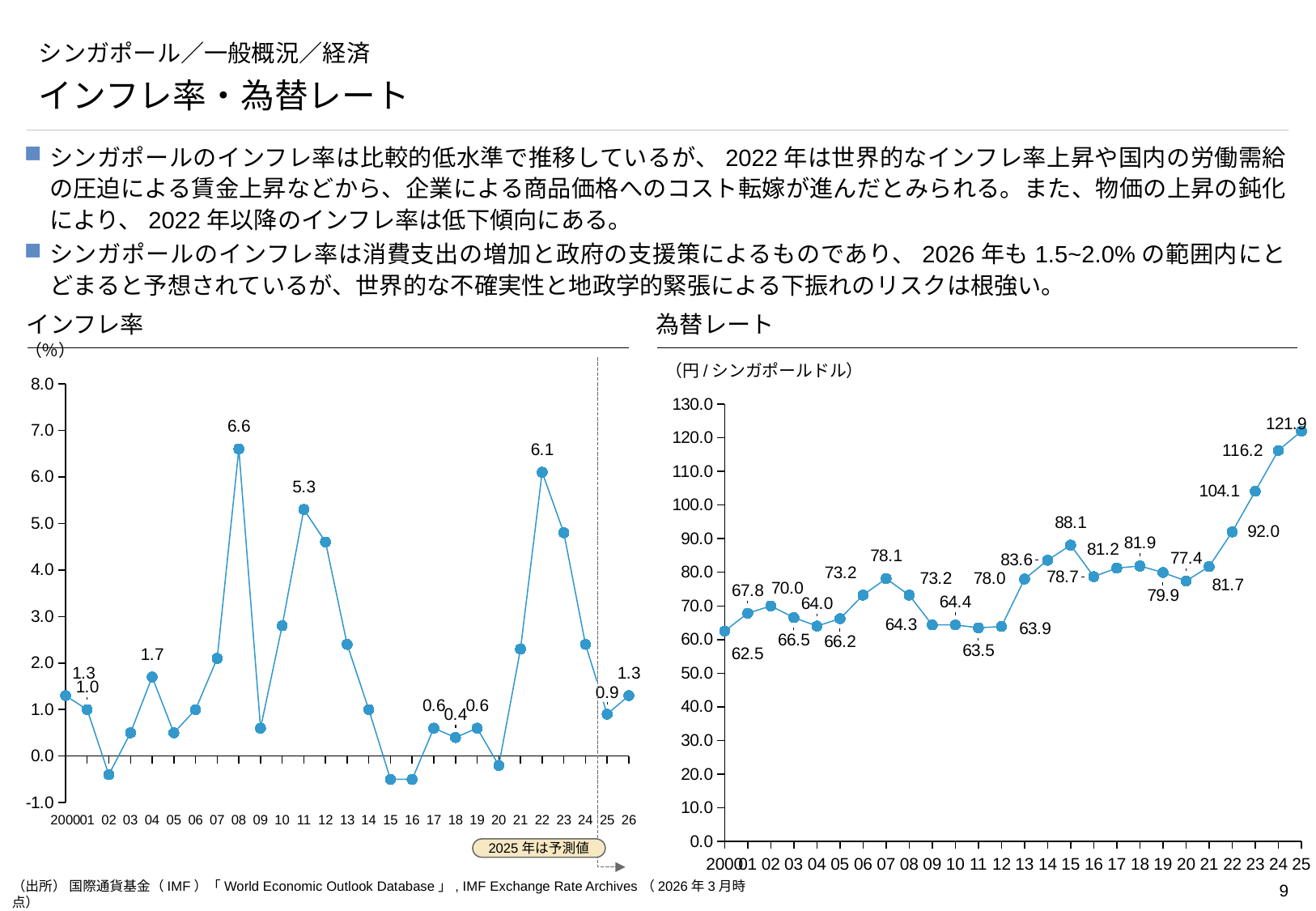
In the 為替レート chart, which year has the lowest value? 2000 In the インフレ率 chart, is the value for 2023 greater or less than 4.0? greater In the 為替レート chart, what is the difference between the 2025 value and the 2024 value? 5.7 What kind of chart is the インフレ率 chart? line chart In the インフレ率 chart, what is the difference between the 2008 value and the 2022 value? 0.5 In the インフレ率 chart, what is the value shown for 2026? 1.3 In the インフレ率 chart, which year has the highest inflation rate? 2008 What unit is shown on the 為替レート chart's axis? 円/シンガポールドル In the インフレ率 chart, what is the inflation rate for 2022? 6.1 In the 為替レート chart, do the values rise or fall from 2021 to 2025? rise In the 為替レート chart, which year has the highest value? 2025 In the 為替レート chart, what is the value for 2015? 88.1